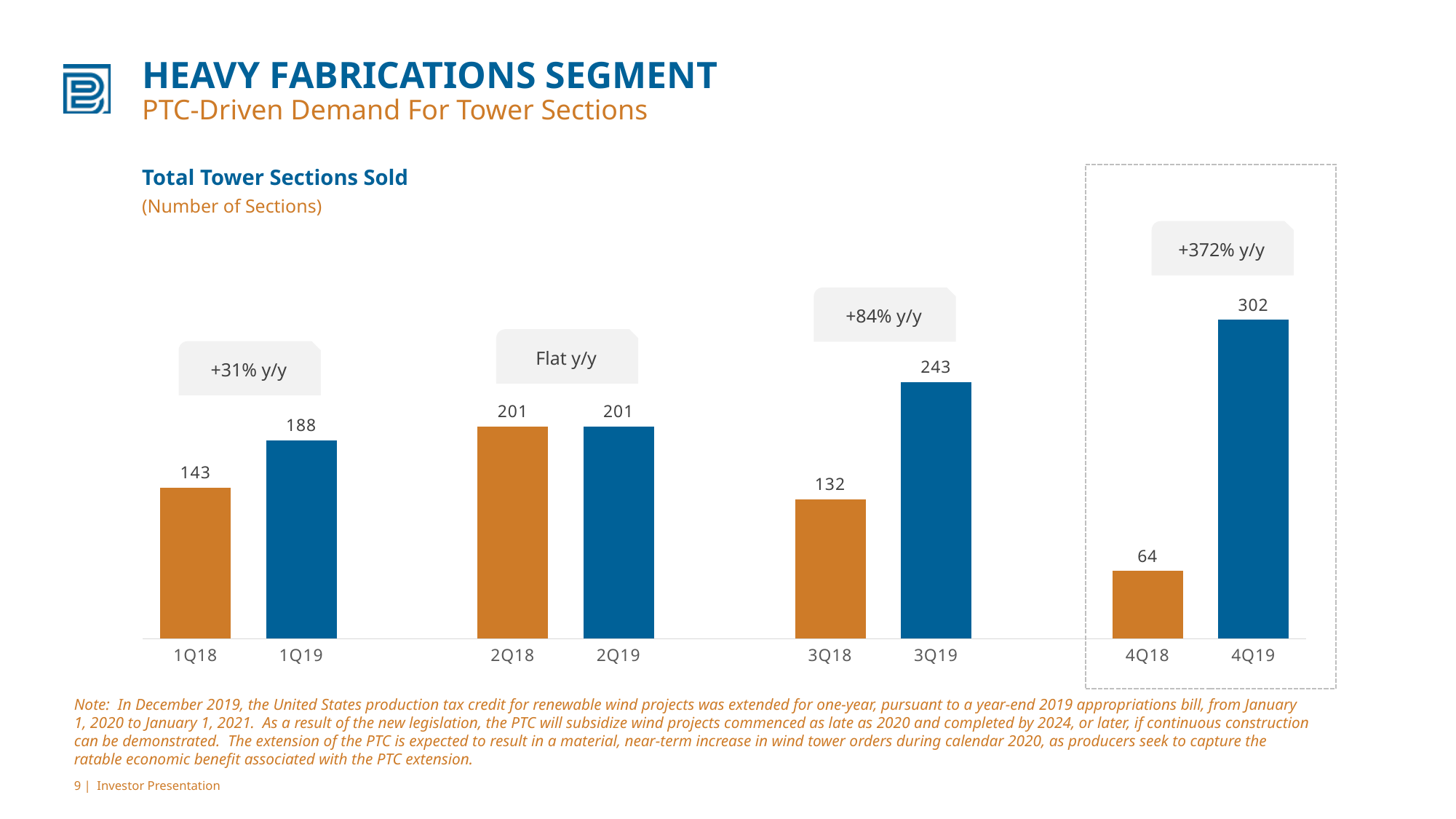
What is the value for 1Q18 in the Total Tower Sections Sold chart? 143 Which is larger, the value for 1Q19 or the value for 2Q19? 2Q19 What is the difference between the values for 3Q19 and 3Q18? 111 What is the difference between the values for 4Q19 and 4Q18? 238 What is the value for 3Q18? 132 Which quarter has the lowest number of tower sections sold? 4Q18 Which quarter has the highest number of tower sections sold? 4Q19 How many tower sections were sold in 4Q19? 302 What is the subtitle shown under the chart title 'Total Tower Sections Sold'? (Number of Sections) How many bars are shown in the chart? 8 What year-over-year change is labelled above the 3Q18/3Q19 pair of bars? +84% y/y What kind of chart is shown on the slide? Bar chart